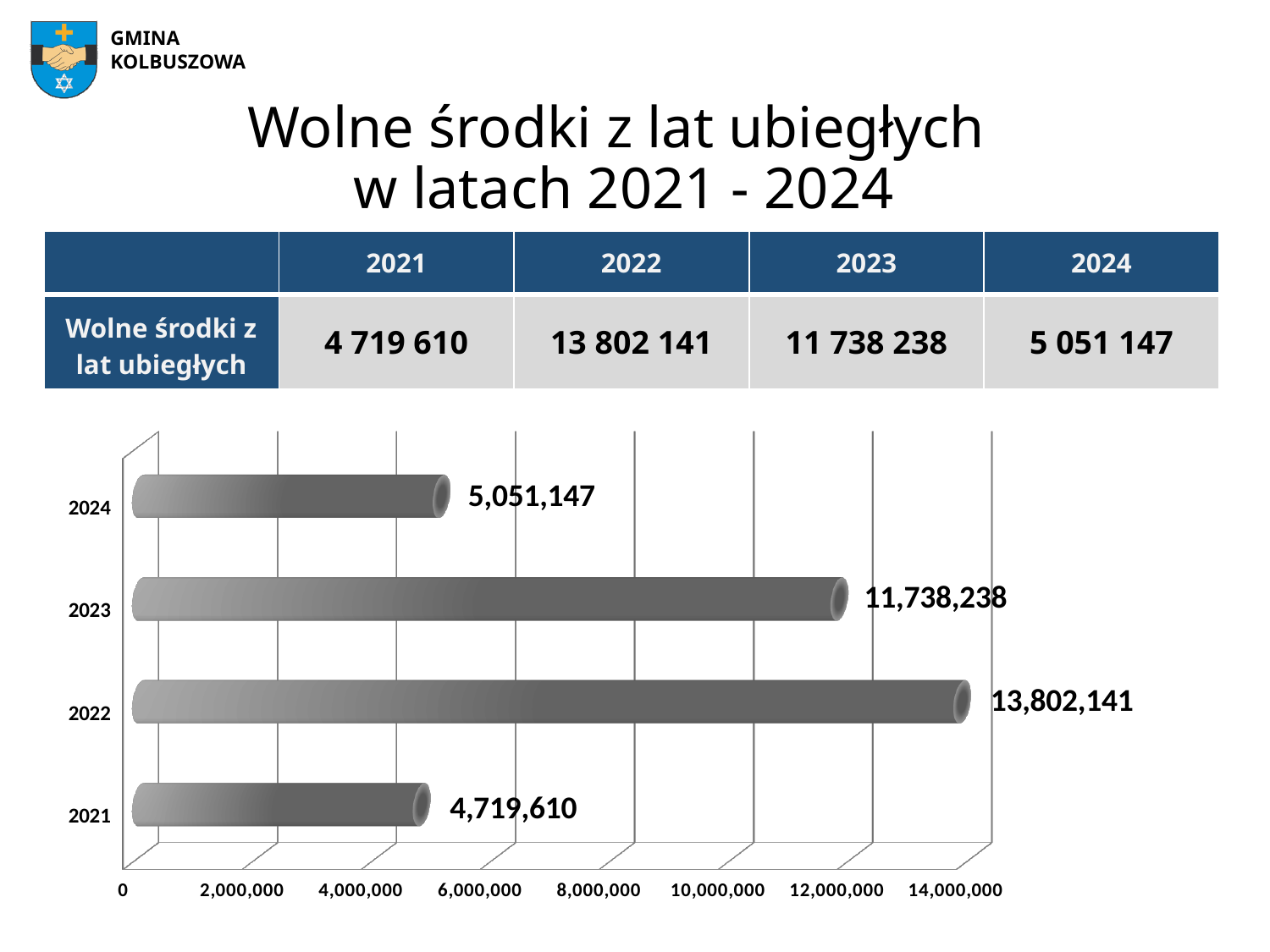
How many years are shown in the chart? 4 Which year has the lowest value in the chart? 2021 What is the value for 2023 in the chart? 11,738,238 Which is larger, the value for 2023 or the value for 2024? 2023 What is the difference between the values for 2023 and 2024? 6,687,091 What kind of chart is shown on the slide? bar chart What is the difference between the values for 2022 and 2021? 9,082,531 Is the value for 2023 greater or less than 10,000,000? greater What is the value for 2022 in the chart? 13,802,141 What is the value for 2024 in the chart? 5,051,147 What is the value for 2021 in the chart? 4,719,610 Which year has the highest value in the chart? 2022